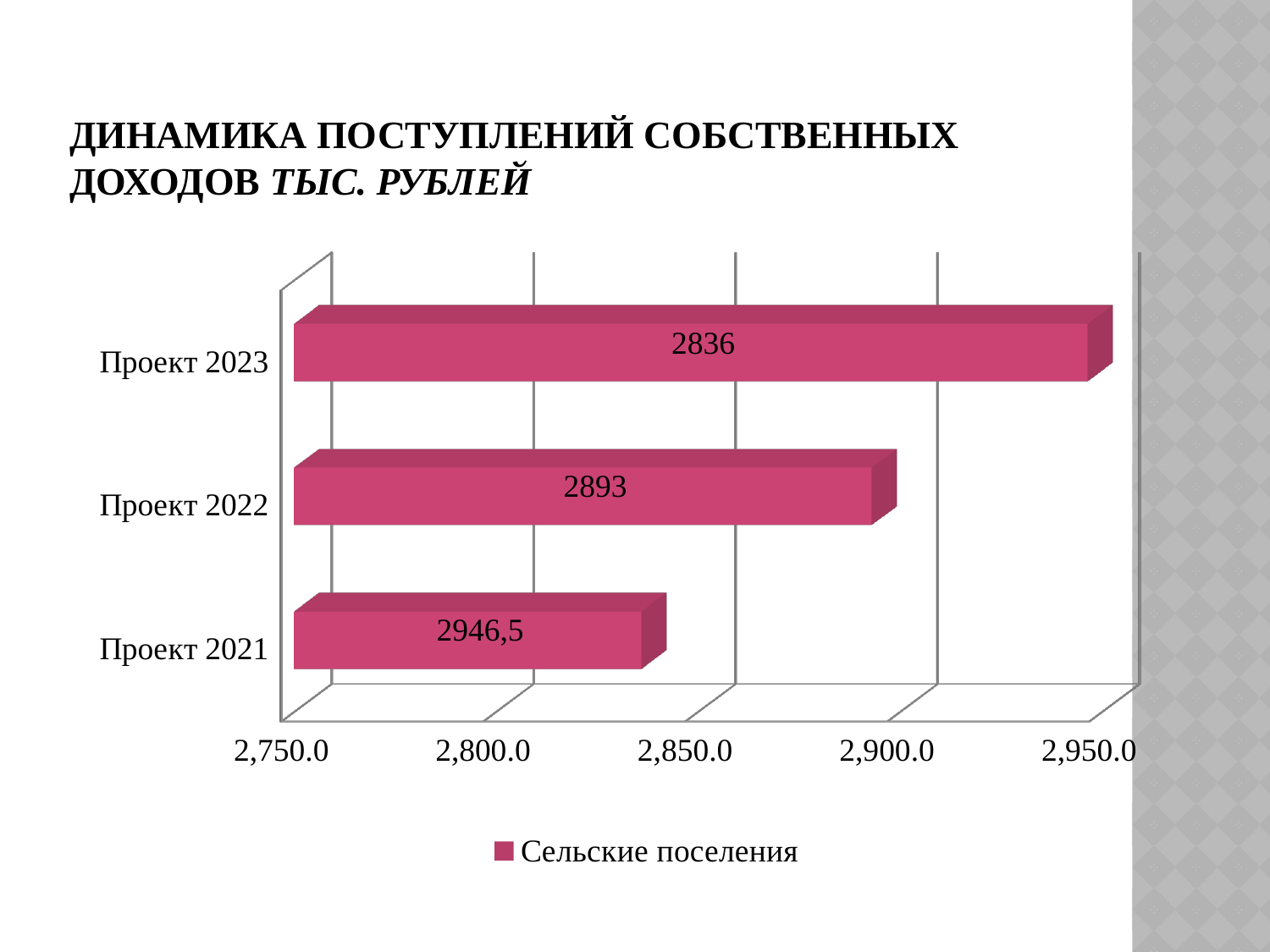
Is the value for Проект 2022 greater or less than 2,850.0? greater What value is labelled on the bar for Проект 2023? 2836 What value is labelled on the bar for Проект 2022? 2893 What value is labelled on the bar for Проект 2021? 2946,5 How many categories are shown on the chart? 3 What kind of chart is shown on the slide? Bar chart How many series does the legend list? 1 What is the difference between the labelled values for Проект 2022 and Проект 2023? 57 What is the name of the series shown in the legend? Сельские поселения What is the title of the chart on the slide? ДИНАМИКА ПОСТУПЛЕНИЙ СОБСТВЕННЫХ ДОХОДОВ ТЫС. РУБЛЕЙ